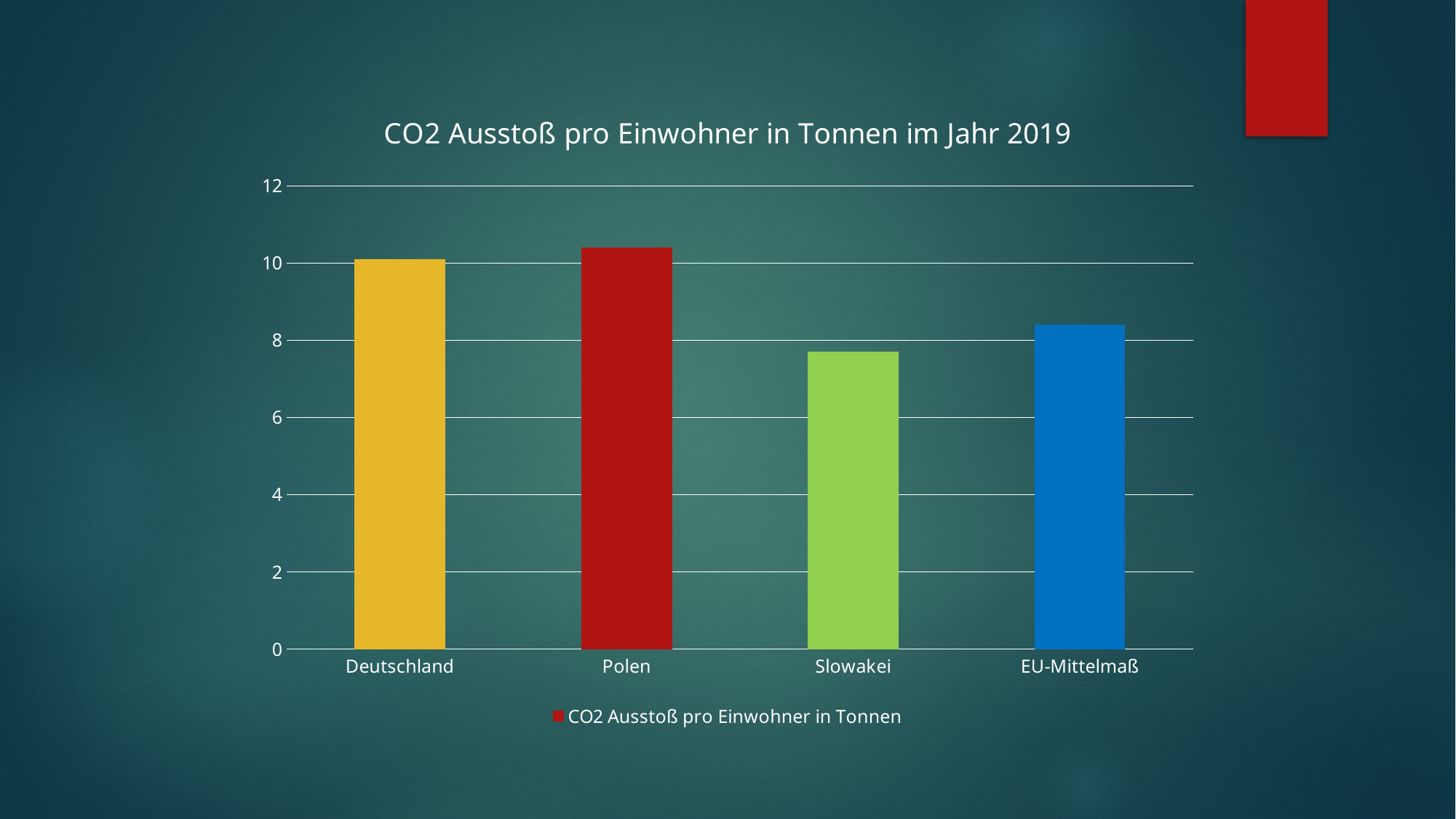
Which category has the lowest CO2 Ausstoß pro Einwohner? Slowakei What kind of chart is shown on the slide? bar chart How many categories are shown on the x axis of the chart? 4 How many series does the chart legend list? 1 Which is larger, the value for Polen or the value for EU-Mittelmaß? Polen Is the value for Slowakei greater or less than 8? less Is the value for EU-Mittelmaß greater or less than 8? greater What colour is the bar for Slowakei? green Is the value for Polen greater or less than 10? greater What is the title of the chart? CO2 Ausstoß pro Einwohner in Tonnen im Jahr 2019 Which is larger, the value for Deutschland or the value for Slowakei? Deutschland Which is larger, the value for Slowakei or the value for EU-Mittelmaß? EU-Mittelmaß